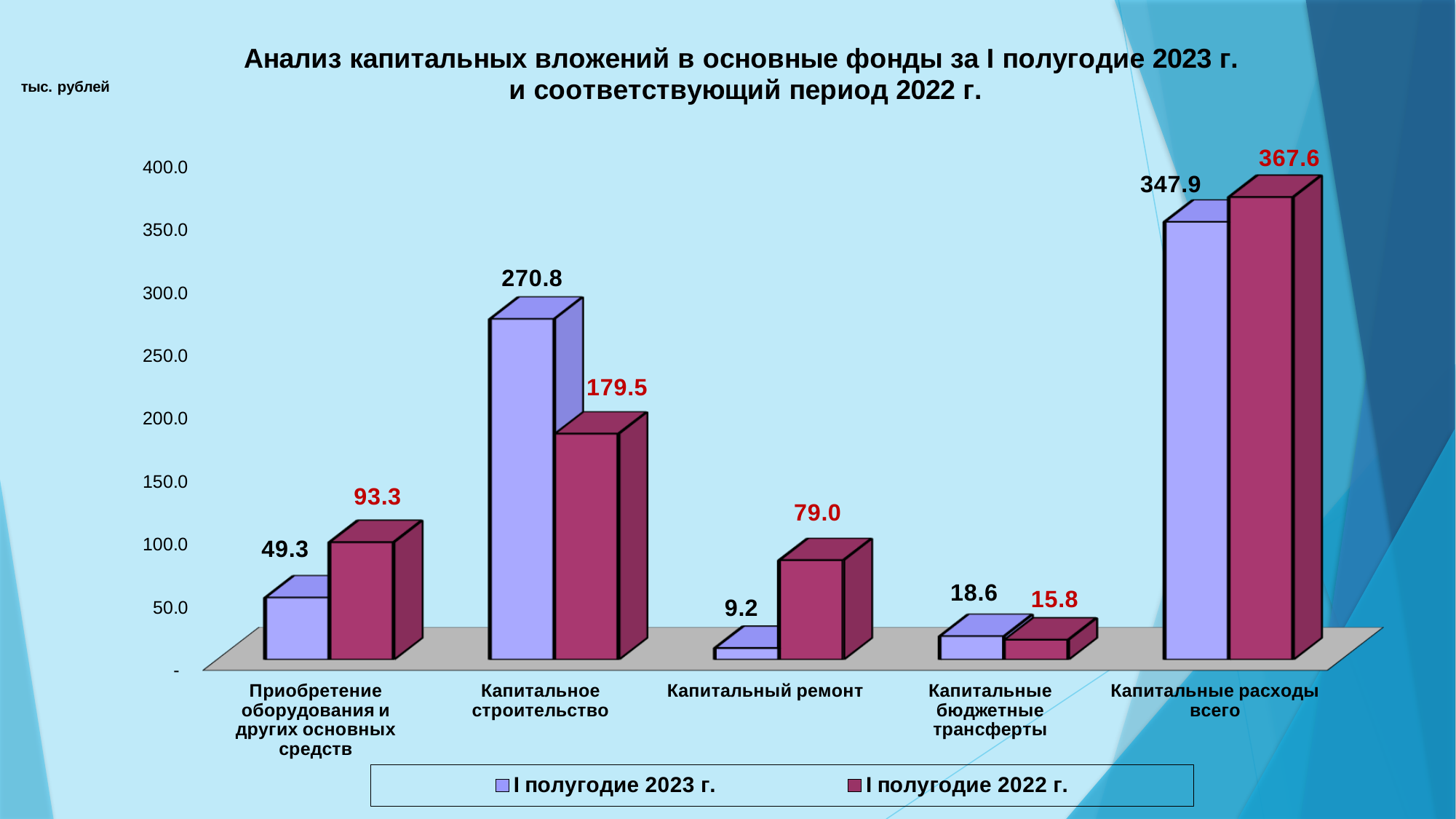
How many series does the legend list? 2 What is the difference between the I полугодие 2022 г. and I полугодие 2023 г. values for Капитальные расходы всего? 19.7 What is the value for Капитальный ремонт in the I полугодие 2022 г. series? 79.0 How many categories are shown on the x axis? 5 What is the value for Капитальное строительство in the I полугодие 2023 г. series? 270.8 Which category has the highest value in the I полугодие 2022 г. series? Капитальные расходы всего What is the difference between the I полугодие 2023 г. and I полугодие 2022 г. values for Капитальное строительство? 91.3 Which is larger for Приобретение оборудования и других основных средств: the I полугодие 2023 г. value or the I полугодие 2022 г. value? I полугодие 2022 г. What kind of chart is shown on the slide? Bar chart What unit is indicated for the values on the chart? тыс. рублей What is the value for Капитальные бюджетные трансферты in the I полугодие 2023 г. series? 18.6 Which category has the lowest value in the I полугодие 2023 г. series? Капитальный ремонт